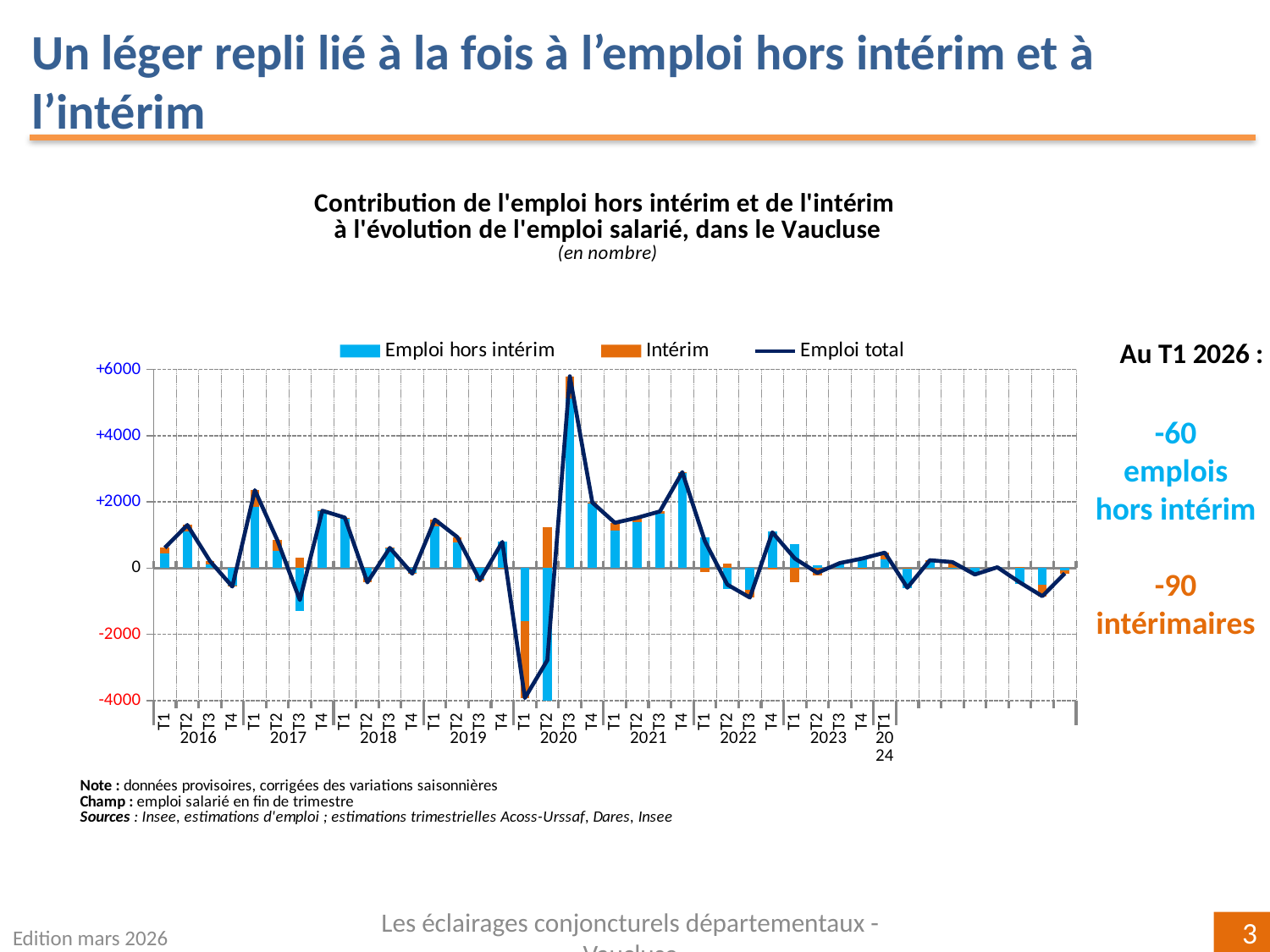
Is the value of 'Emploi total' at T1 2020 greater or less than -2000? less Is the value of 'Emploi total' at T4 2021 greater or less than +2000? greater Is the value of 'Emploi total' at T3 2020 greater or less than +4000? greater Which series in the legend is drawn as a line rather than bars? Emploi total Which is larger, the 'Emploi total' value at T3 2020 or at T4 2021? T3 2020 What colour are the bars for the 'Intérim' series? Orange According to the text beside the chart, what is the change in 'emplois hors intérim' at T1 2026? -60 What kind of chart is shown on the slide? A combined bar and line chart In which quarter does the 'Emploi total' line reach its lowest point? T1 2020 In which quarter does the 'Emploi total' line reach its highest point? T3 2020 How many series does the chart legend list? 3 According to the text beside the chart, what is the change in 'intérimaires' at T1 2026? -90